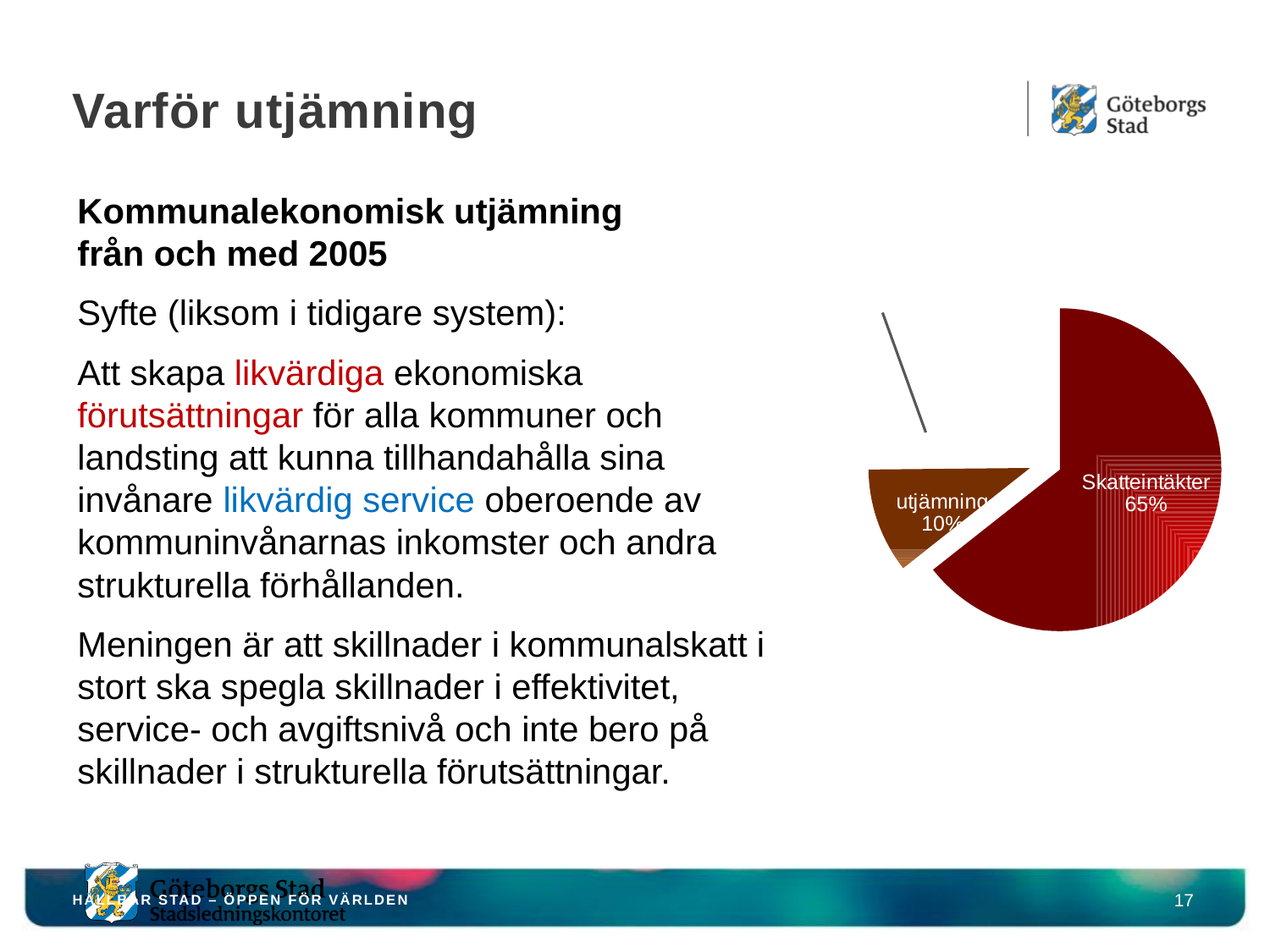
Is the share for utjämning greater or less than 25%? less By how many percentage points does Skatteintäkter exceed utjämning in the pie chart? 55 percentage points What percentage does the Skatteintäkter slice of the pie chart represent? 65% Which is larger in the pie chart, Skatteintäkter or utjämning? Skatteintäkter Is the share for Skatteintäkter greater or less than 50%? greater What kind of chart is shown on the slide? Pie chart Which labelled slice of the pie chart is the largest? Skatteintäkter What percentage does the utjämning slice of the pie chart represent? 10% What colour is the Skatteintäkter slice of the pie chart? Dark red What colour is the utjämning slice of the pie chart? Brown